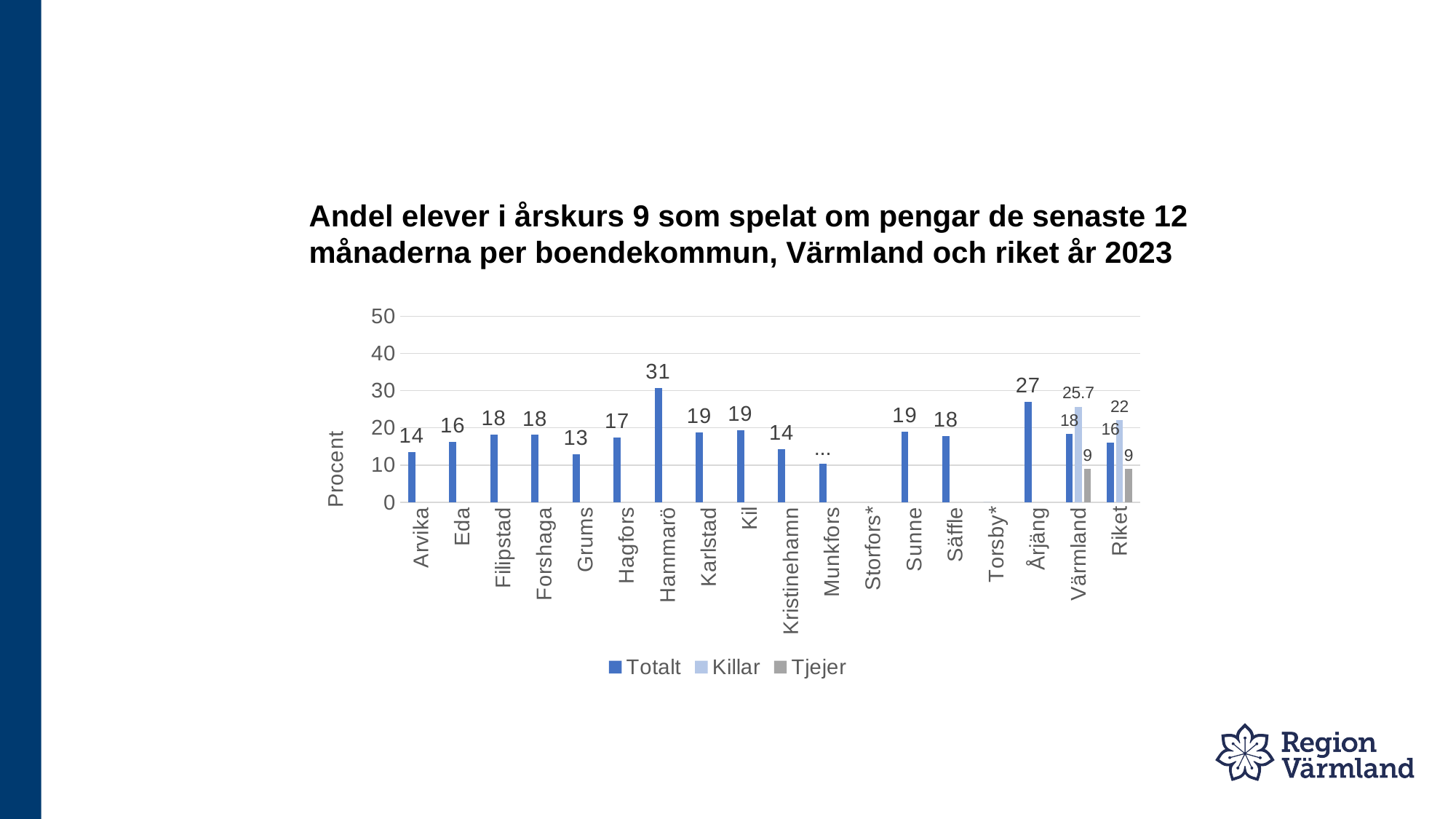
Which has a higher Totalt value, Värmland or Riket? Värmland What kind of chart is shown on the slide? Bar chart How many categories are shown on the x axis? 18 Which category has the highest Totalt value? Hammarö What is the label on the y axis? Procent How many series does the legend list? 3 What is the difference between the Totalt values for Hammarö and Årjäng? 4 Which has a higher Totalt value, Karlstad or Arvika? Karlstad What is the Tjejer value for Riket? 9 What is the Totalt value for Hammarö? 31 What is the difference between the Killar and Tjejer values for Värmland? 16.7 What is the Killar value for Värmland? 25.7